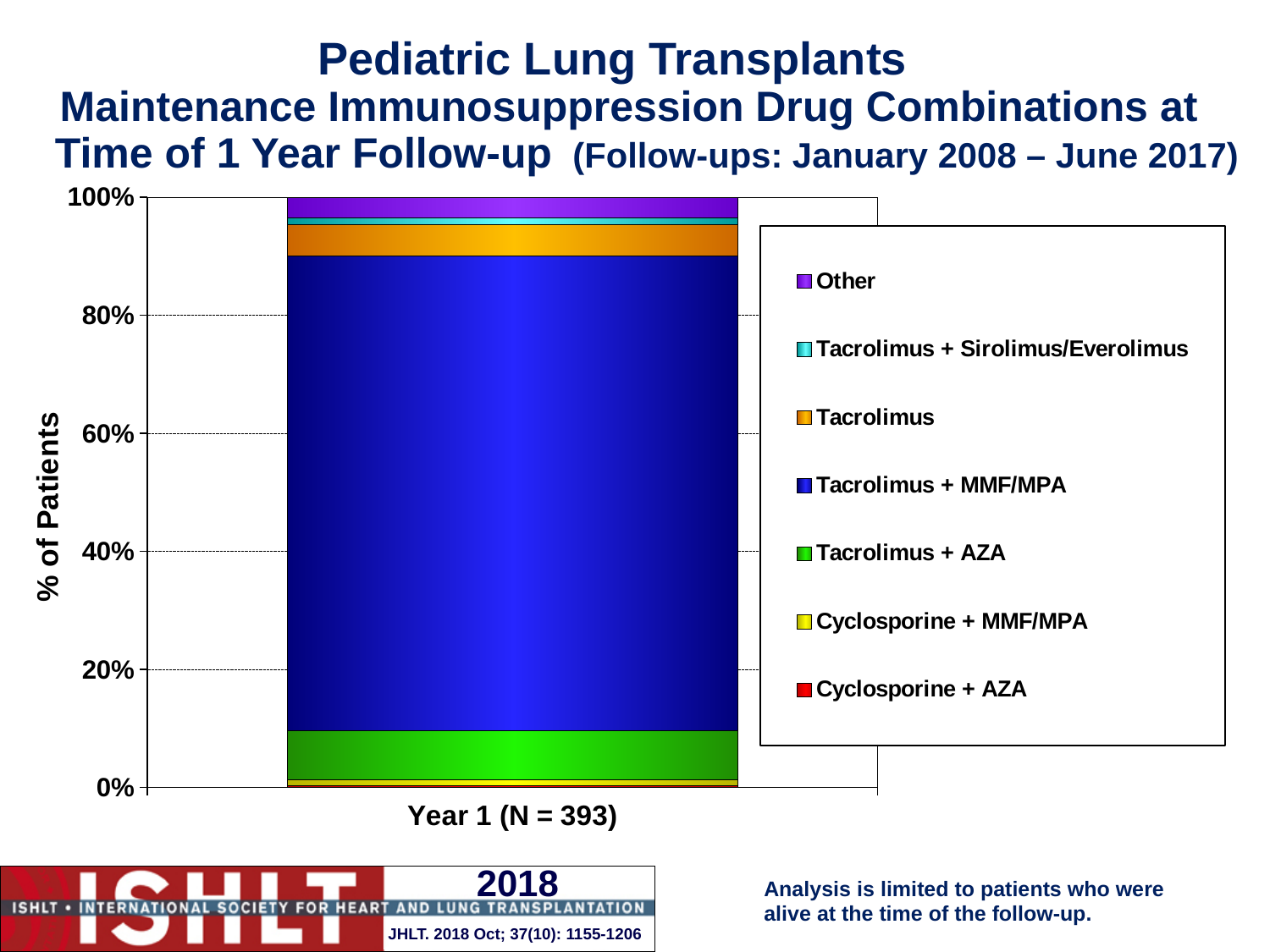
Is the value for Tacrolimus + AZA greater or less than 20%? less Is the value for Other greater or less than 20%? less What is the N shown in the x-axis category label? 393 Which is larger at Year 1: Tacrolimus + MMF/MPA or Tacrolimus + AZA? Tacrolimus + MMF/MPA How many categories are plotted on the x axis? 1 What kind of chart is shown on the slide? Stacked bar chart Which is larger at Year 1: Tacrolimus + AZA or Tacrolimus alone? Tacrolimus + AZA Which drug combination accounts for the largest share of patients at Year 1? Tacrolimus + MMF/MPA How many series does the legend list? 7 Is the value for Tacrolimus + MMF/MPA greater or less than 60%? greater What is the total of the stacked bar for Year 1? 100% What is the label of the y axis? % of Patients